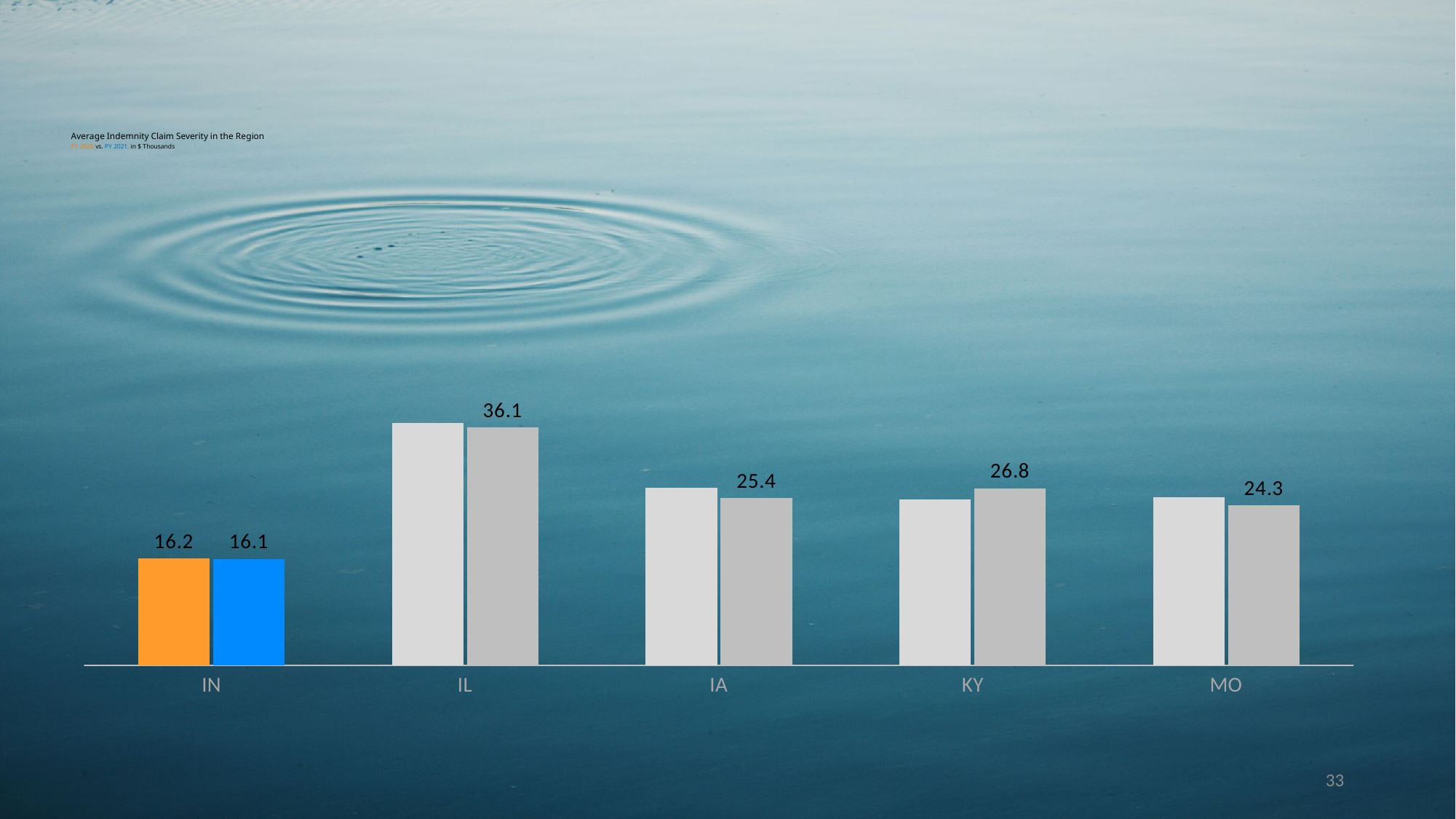
What is the difference between the labeled values for IL and IA? 10.7 Which state has the highest labeled value? IL What is the title of the chart? Average Indemnity Claim Severity in the Region How many states (categories) are shown on the x axis? 5 What is the value of the blue bar for IN? 16.1 Which has the larger labeled value, KY or MO? KY What is the labeled value for IA? 25.4 What is the labeled value for MO? 24.3 What kind of chart is shown on the slide? bar chart What is the labeled value for KY? 26.8 What is the value of the orange bar for IN? 16.2 What is the labeled value for IL? 36.1